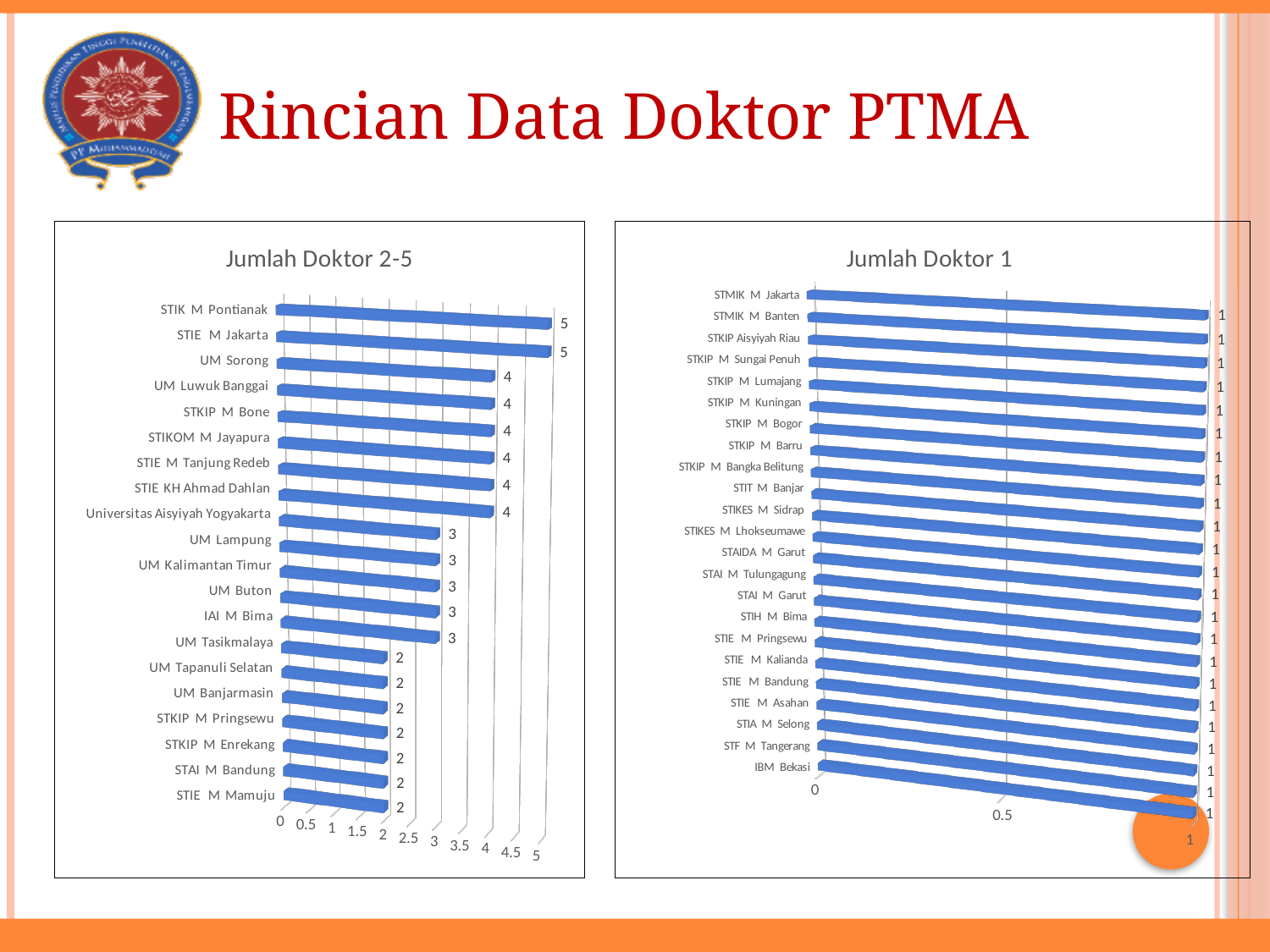
In the 'Jumlah Doktor 2-5' chart, what is the value for STKIP M Enrekang? 2 In the 'Jumlah Doktor 2-5' chart, is the value for UM Kalimantan Timur greater or less than 2.5? greater In the 'Jumlah Doktor 2-5' chart, what is the highest value shown? 5 How many categories are shown in the 'Jumlah Doktor 2-5' chart? 20 In the 'Jumlah Doktor 2-5' chart, what is the value for Universitas Aisyiyah Yogyakarta? 3 In the 'Jumlah Doktor 2-5' chart, what is the difference between the values for STIE M Jakarta and UM Tasikmalaya? 3 In the 'Jumlah Doktor 2-5' chart, what is the value for UM Lampung? 3 In the 'Jumlah Doktor 2-5' chart, what is the value for STIK M Pontianak? 5 What type of chart is the 'Jumlah Doktor 1' chart? bar chart In the 'Jumlah Doktor 2-5' chart, which has a larger value, UM Sorong or UM Buton? UM Sorong In the 'Jumlah Doktor 2-5' chart, what is the lowest value shown? 2 In the 'Jumlah Doktor 1' chart, what is the value for STKIP M Bogor? 1